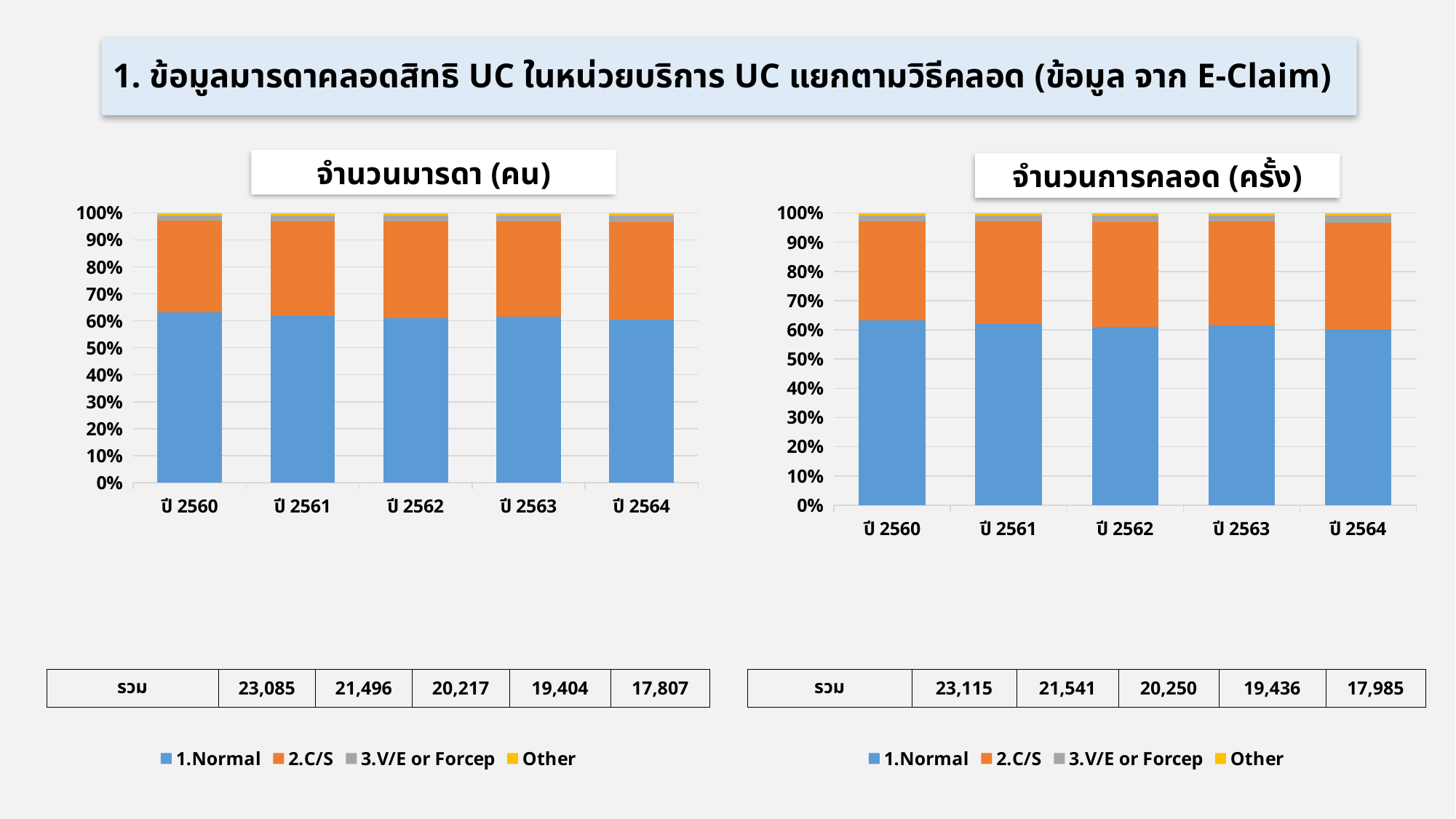
How many series does the legend of the right chart titled จำนวนการคลอด (ครั้ง) list? 4 How many year categories are shown on the x axis of the left chart titled จำนวนมารดา (คน)? 5 In the left chart titled จำนวนมารดา (คน), which series occupies the largest portion of each bar? 1.Normal In the left chart titled จำนวนมารดา (คน), what is the รวม (total) value shown for ปี 2560? 23,085 What colour represents the 2.C/S series in the legend of the left chart titled จำนวนมารดา (คน)? Orange In the right chart titled จำนวนการคลอด (ครั้ง), do the รวม (total) values rise or fall from ปี 2560 to ปี 2564? fall In the right chart titled จำนวนการคลอด (ครั้ง), is the share for 1.Normal in ปี 2560 greater or less than 50%? greater In the left chart titled จำนวนมารดา (คน), what is the difference between the รวม values for ปี 2560 and ปี 2564? 5,278 In the right chart titled จำนวนการคลอด (ครั้ง), what is the รวม (total) value shown for ปี 2564? 17,985 What kind of chart is the left chart titled จำนวนมารดา (คน)? Stacked bar chart In the right chart titled จำนวนการคลอด (ครั้ง), which series is larger in ปี 2562: 1.Normal or 2.C/S? 1.Normal In the left chart titled จำนวนมารดา (คน), is the share for 1.Normal in ปี 2560 greater or less than 60%? greater